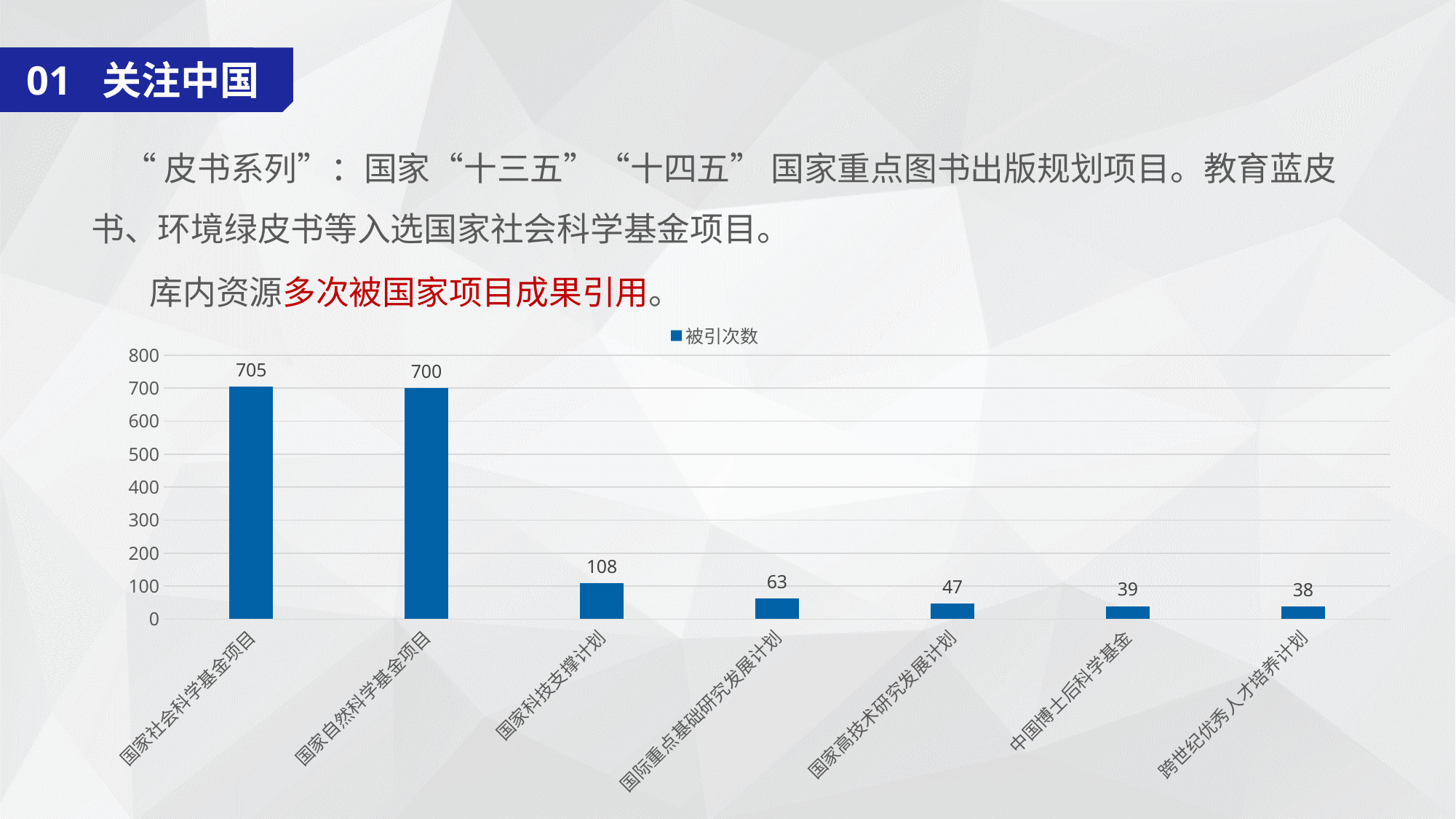
Is the value for 国家自然科学基金项目 greater or less than 600? greater How many categories are shown on the x axis? 7 Which category has the highest value? 国家社会科学基金项目 Which category has the lowest value? 跨世纪优秀人才培养计划 What is the value for 国家社会科学基金项目? 705 What is the difference between the values for 国家社会科学基金项目 and 国家自然科学基金项目? 5 What is the difference between the values for 国家科技支撑计划 and 国际重点基础研究发展计划? 45 What is the value for 国家科技支撑计划? 108 What is the name of the series shown in the legend? 被引次数 What is the value for 中国博士后科学基金? 39 Which is larger, the value for 国家高技术研究发展计划 or the value for 国际重点基础研究发展计划? 国际重点基础研究发展计划 What kind of chart is shown on the slide? bar chart